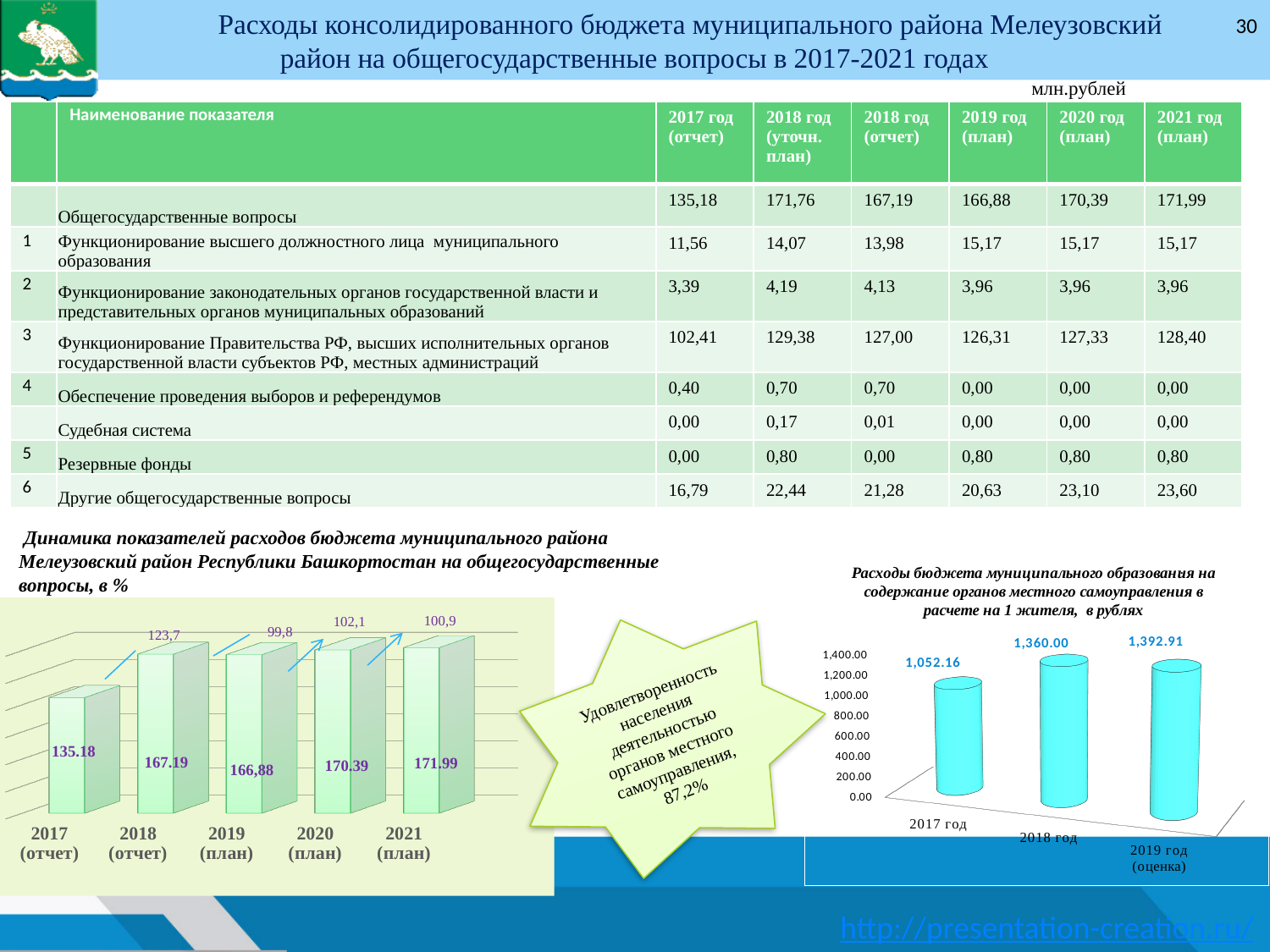
In the right chart (Расходы бюджета на содержание органов местного самоуправления в расчете на 1 жителя), which year has the lowest value? 2017 год In the right chart (Расходы бюджета на содержание органов местного самоуправления в расчете на 1 жителя), do the values rise or fall from 2017 to 2019? rise In the left chart (Динамика показателей расходов бюджета), what is the value for 2017 (отчет)? 135.18 In the left chart (Динамика показателей расходов бюджета), what percentage label is shown above the 2018 bar? 123,7 In the right chart (Расходы бюджета на содержание органов местного самоуправления в расчете на 1 жителя), what is the value for 2017 год? 1,052.16 In the right chart (Расходы бюджета на содержание органов местного самоуправления в расчете на 1 жителя), what is the value for 2019 год (оценка)? 1,392.91 In the left chart (Динамика показателей расходов бюджета), what is the value for 2021 (план)? 171.99 In the left chart (Динамика показателей расходов бюджета), what is the difference between the 2018 (отчет) value and the 2017 (отчет) value? 32.01 What kind of chart is the right chart (Расходы бюджета на содержание органов местного самоуправления в расчете на 1 жителя)? bar chart In the left chart (Динамика показателей расходов бюджета), how many years are shown on the x axis? 5 In the left chart (Динамика показателей расходов бюджета), which year has the highest value? 2021 (план) In the left chart (Динамика показателей расходов бюджета), which year has the lowest value? 2017 (отчет)